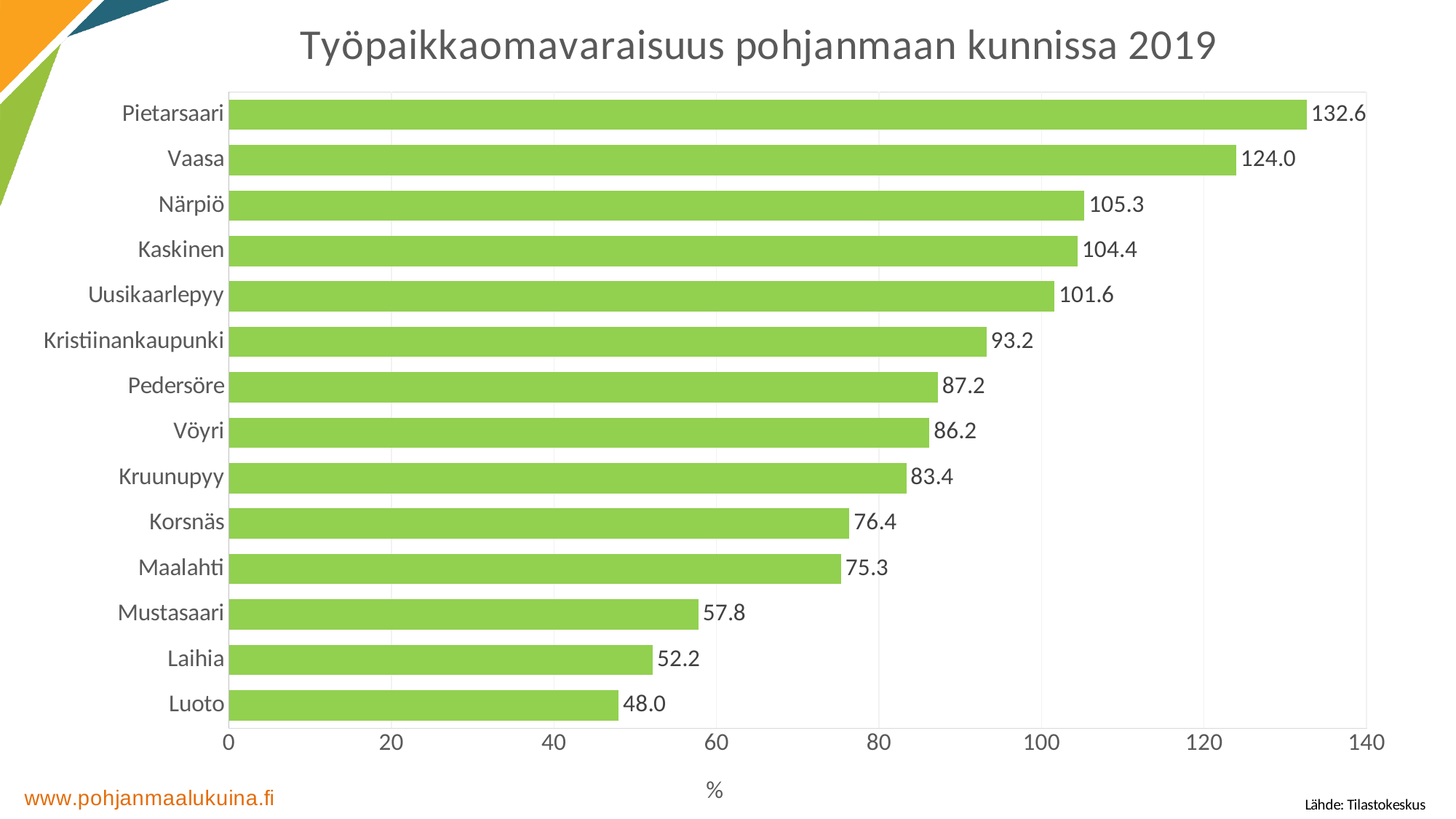
Which municipality has the highest value? Pietarsaari What is the value for Mustasaari? 57.8 What is the value for Vaasa? 124.0 How many municipalities are shown in the chart? 14 What kind of chart is shown on the slide? bar chart Which has a larger value, Närpiö or Uusikaarlepyy? Närpiö What is the difference between the values for Laihia and Luoto? 4.2 What is the difference between the values for Pietarsaari and Vaasa? 8.6 What is the value for Kristiinankaupunki? 93.2 Is the value for Korsnäs greater or less than 80? less What is the title of the chart? Työpaikkaomavaraisuus pohjanmaan kunnissa 2019 Which municipality has the lowest value? Luoto